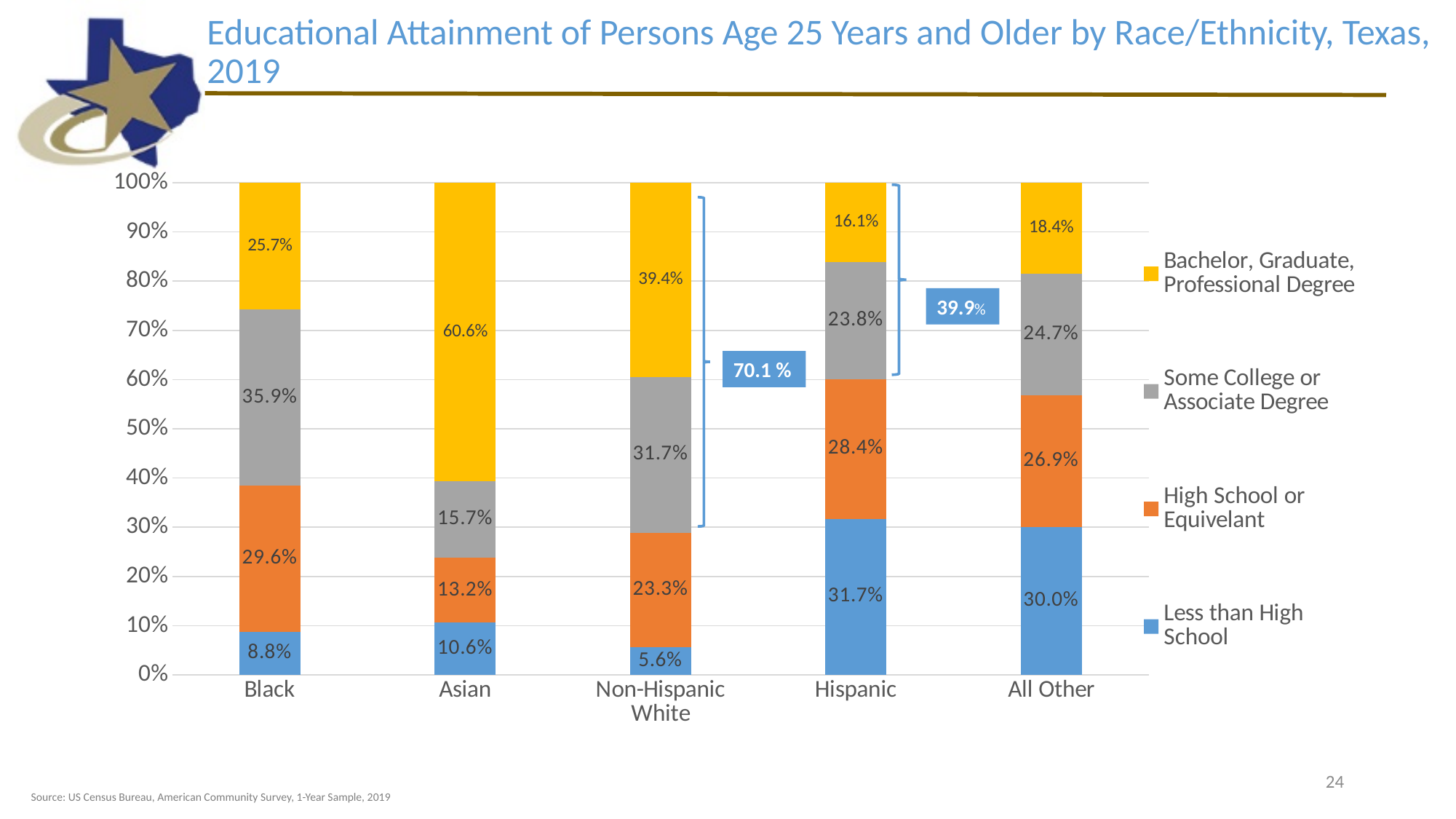
Which colour represents the Less than High School series in the legend? Blue What is the High School or Equivelant share for the All Other group? 26.9% Which race/ethnicity group has the highest share with a Bachelor, Graduate, or Professional Degree? Asian What is the Less than High School share for Hispanic persons? 31.7% Which race/ethnicity group has the lowest Less than High School share? Non-Hispanic White What percentage of Black persons age 25 and older have a Bachelor, Graduate, or Professional Degree? 25.7% How many race/ethnicity categories are shown on the x axis? 5 What is the difference between the Some College or Associate Degree share for Black and for Asian persons? 20.2% Which is larger: the High School or Equivelant share for Black persons or for Non-Hispanic White persons? Black How many series does the legend list? 4 What is the combined share of Some College or Associate Degree and Bachelor, Graduate, Professional Degree for Hispanic persons, as annotated on the chart? 39.9% What kind of chart is shown on the slide? Stacked bar chart